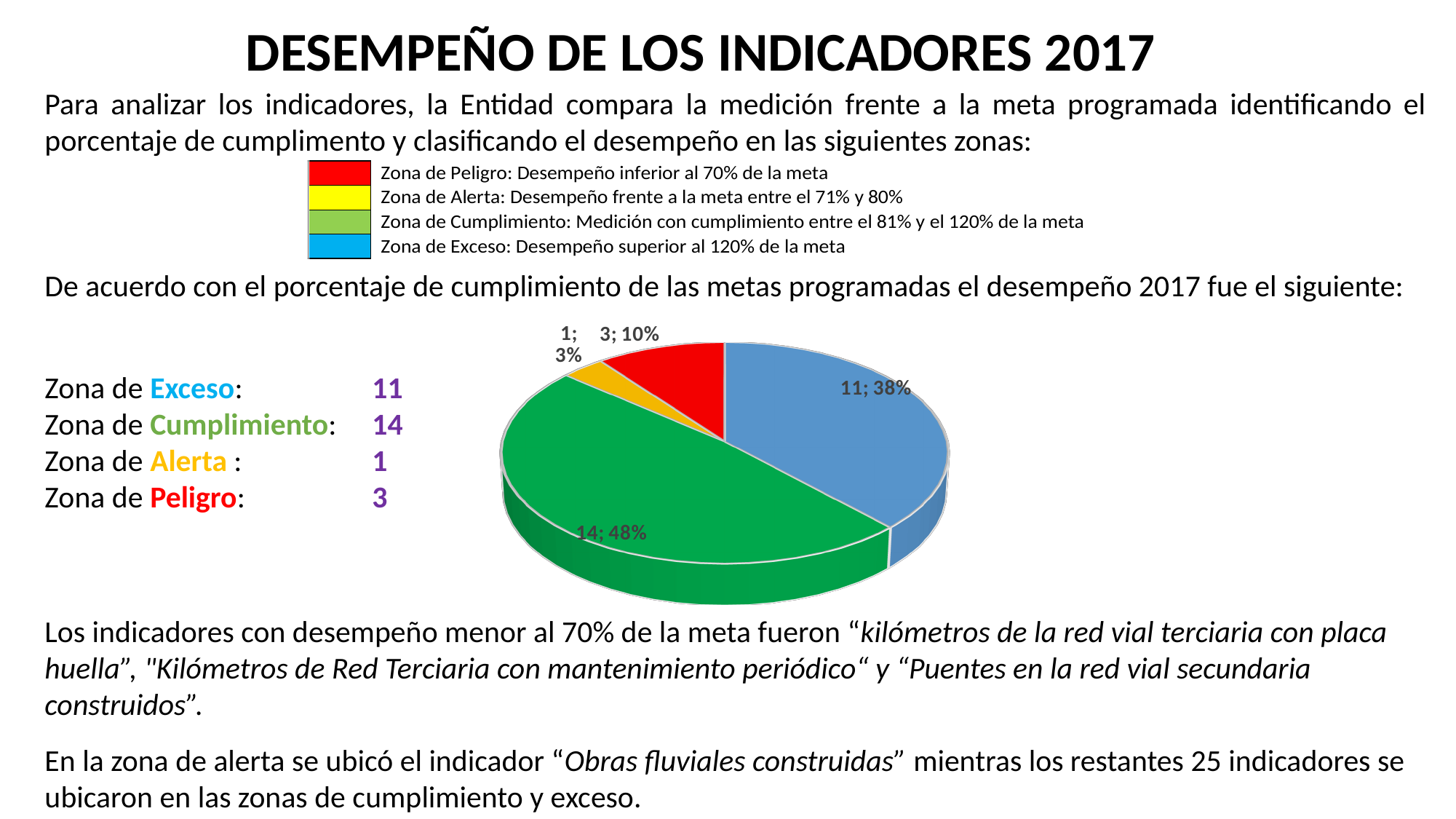
Which slice is larger, the red one (Peligro) or the yellow one (Alerta)? red (Peligro) What is the difference in the number of indicators between the green slice (Cumplimiento) and the blue slice (Exceso)? 3 How many indicators does the blue slice (Zona de Exceso) represent? 11 What share of the pie does the red slice (Zona de Peligro) represent? 10% How many slices does the pie chart have? 4 Which zone has the smallest slice of the pie? Zona de Alerta What share of the pie does the green slice (Zona de Cumplimiento) represent? 48% What kind of chart is shown on the slide? pie chart What share of the pie does the yellow slice (Zona de Alerta) represent? 3% How many indicators does the green slice (Zona de Cumplimiento) represent? 14 Which zone has the largest slice of the pie? Zona de Cumplimiento